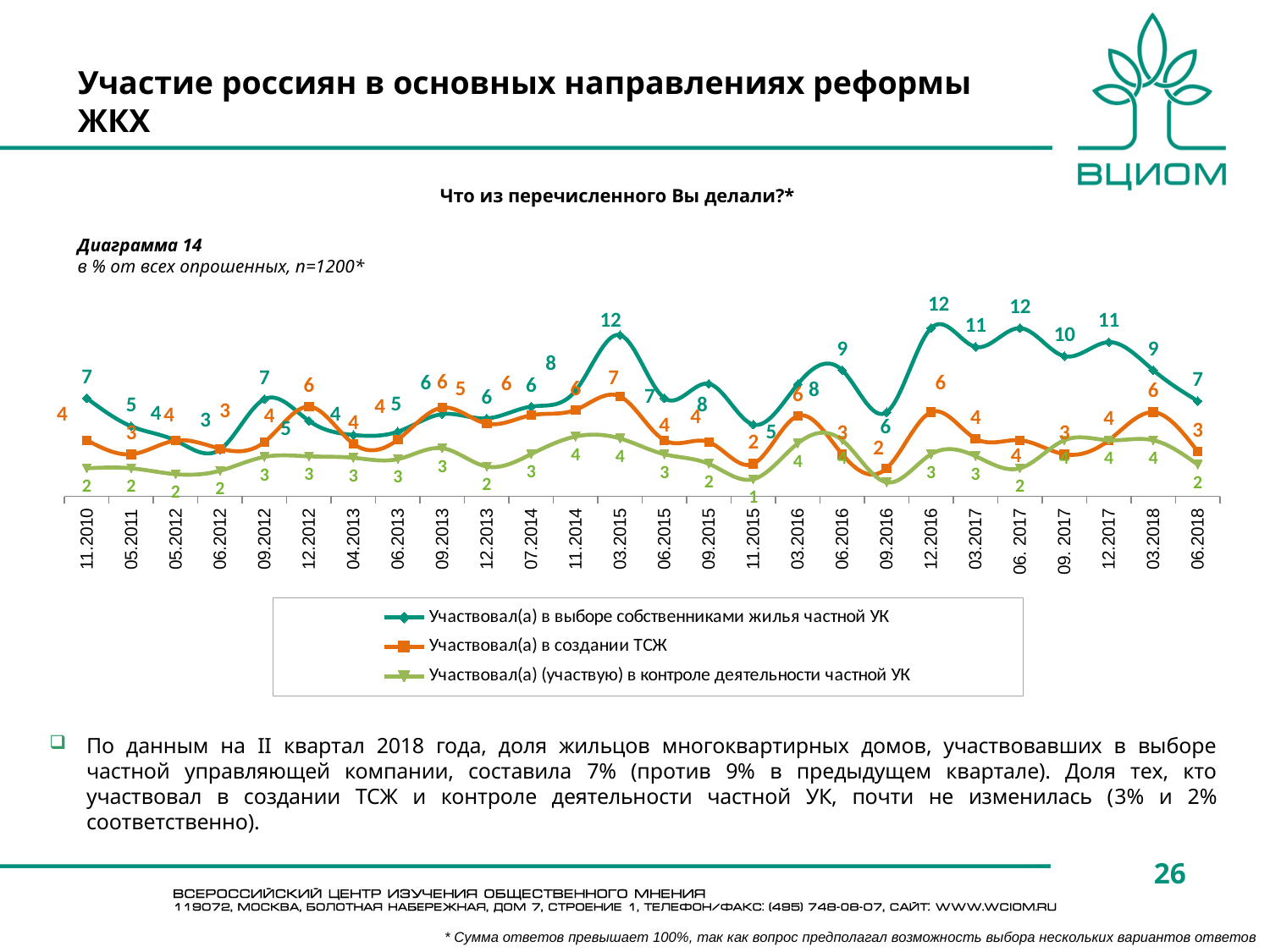
What is the diagram number given above the chart? Диаграмма 14 What is the value for 'Участвовал(а) в создании ТСЖ' at 06.2018? 3 Does the 'Участвовал(а) в выборе собственниками жилья частной УК' series rise or fall from 03.2018 to 06.2018? Fall At which time point does the 'Участвовал(а) в создании ТСЖ' series reach its highest value? 03.2015 Which series has the larger value at 12.2016: 'Участвовал(а) в выборе собственниками жилья частной УК' or 'Участвовал(а) в создании ТСЖ'? Участвовал(а) в выборе собственниками жилья частной УК At which time point does the 'Участвовал(а) (участвую) в контроле деятельности частной УК' series reach its lowest value? 11.2015 and 09.2016 What is the value for 'Участвовал(а) в выборе собственниками жилья частной УК' at 06.2018? 7 What is the difference between the 'Участвовал(а) в выборе собственниками жилья частной УК' value and the 'Участвовал(а) в создании ТСЖ' value at 06.2018? 4 How many time points are plotted along the x axis? 26 What is the value for 'Участвовал(а) (участвую) в контроле деятельности частной УК' at 03.2015? 4 How many series does the legend list? 3 What kind of chart is shown on the slide? Line chart